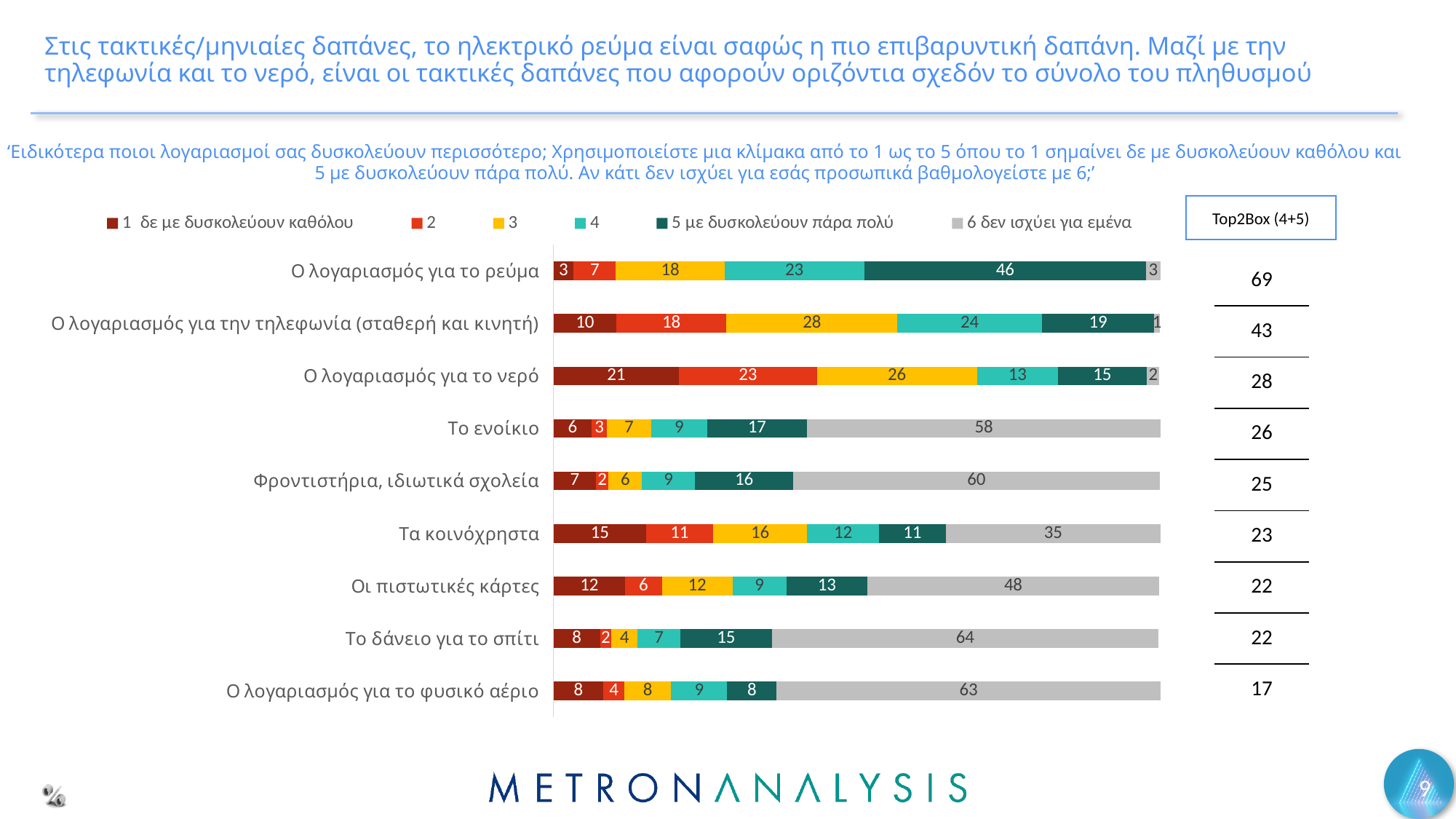
Which category has the highest value in the '5 με δυσκολεύουν πάρα πολύ' series? Ο λογαριασμός για το ρεύμα Which is larger: the '1 δε με δυσκολεύουν καθόλου' value for 'Ο λογαριασμός για το νερό' or for 'Τα κοινόχρηστα'? Ο λογαριασμός για το νερό How many series does the legend list? 6 What is the value of the '6 δεν ισχύει για εμένα' series for 'Το δάνειο για το σπίτι'? 64 What is the value of the '3' series for 'Ο λογαριασμός για την τηλεφωνία (σταθερή και κινητή)'? 28 Which category has the lowest value in the '6 δεν ισχύει για εμένα' series? Ο λογαριασμός για την τηλεφωνία (σταθερή και κινητή) What is the value of the '5 με δυσκολεύουν πάρα πολύ' series for 'Ο λογαριασμός για το ρεύμα'? 46 How many categories (bars) are shown in the chart? 9 What is the Top2Box (4+5) value shown for 'Ο λογαριασμός για το φυσικό αέριο'? 17 What is the total of the '4' and '5 με δυσκολεύουν πάρα πολύ' segments for 'Το ενοίκιο'? 26 What is the difference between the '6 δεν ισχύει για εμένα' values for 'Φροντιστήρια, ιδιωτικά σχολεία' and 'Τα κοινόχρηστα'? 25 What kind of chart is shown on the slide? Stacked bar chart